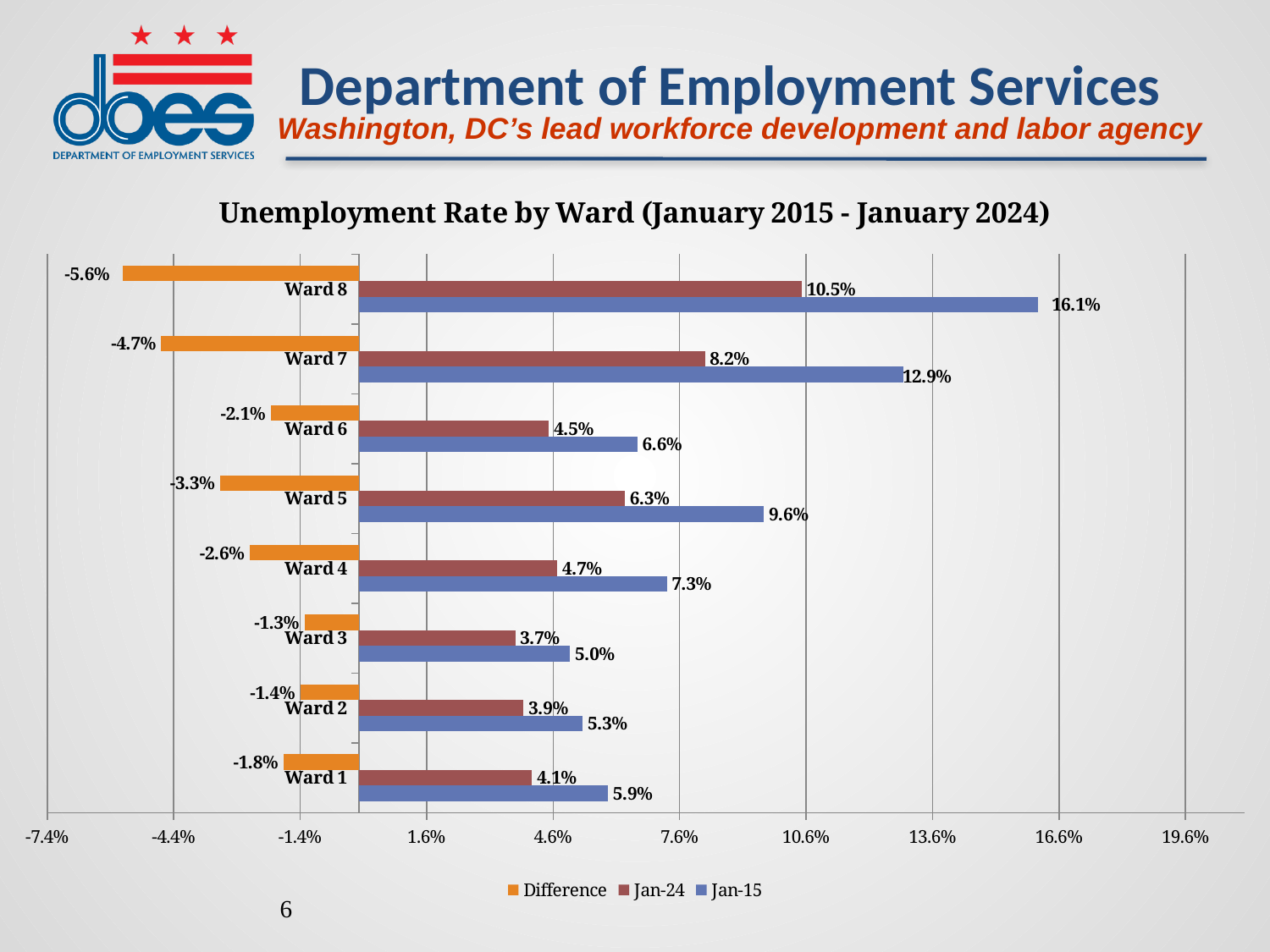
What is the difference between the Jan-15 and Jan-24 unemployment rates for Ward 5? 3.3% Which ward has the lowest Jan-15 unemployment rate? Ward 3 What is the Jan-15 unemployment rate for Ward 8? 16.1% What is the title of the chart? Unemployment Rate by Ward (January 2015 - January 2024) Which ward has the highest Jan-24 unemployment rate? Ward 8 What is the Jan-24 unemployment rate for Ward 3? 3.7% How many series does the legend list? 3 What kind of chart is shown on the slide? Bar chart Which is larger, the Jan-24 rate for Ward 4 or the Jan-24 rate for Ward 6? Ward 4 Is the Jan-15 value for Ward 7 greater or less than 10.6%? greater What is the Difference value shown for Ward 7? -4.7% How many wards are shown on the chart? 8